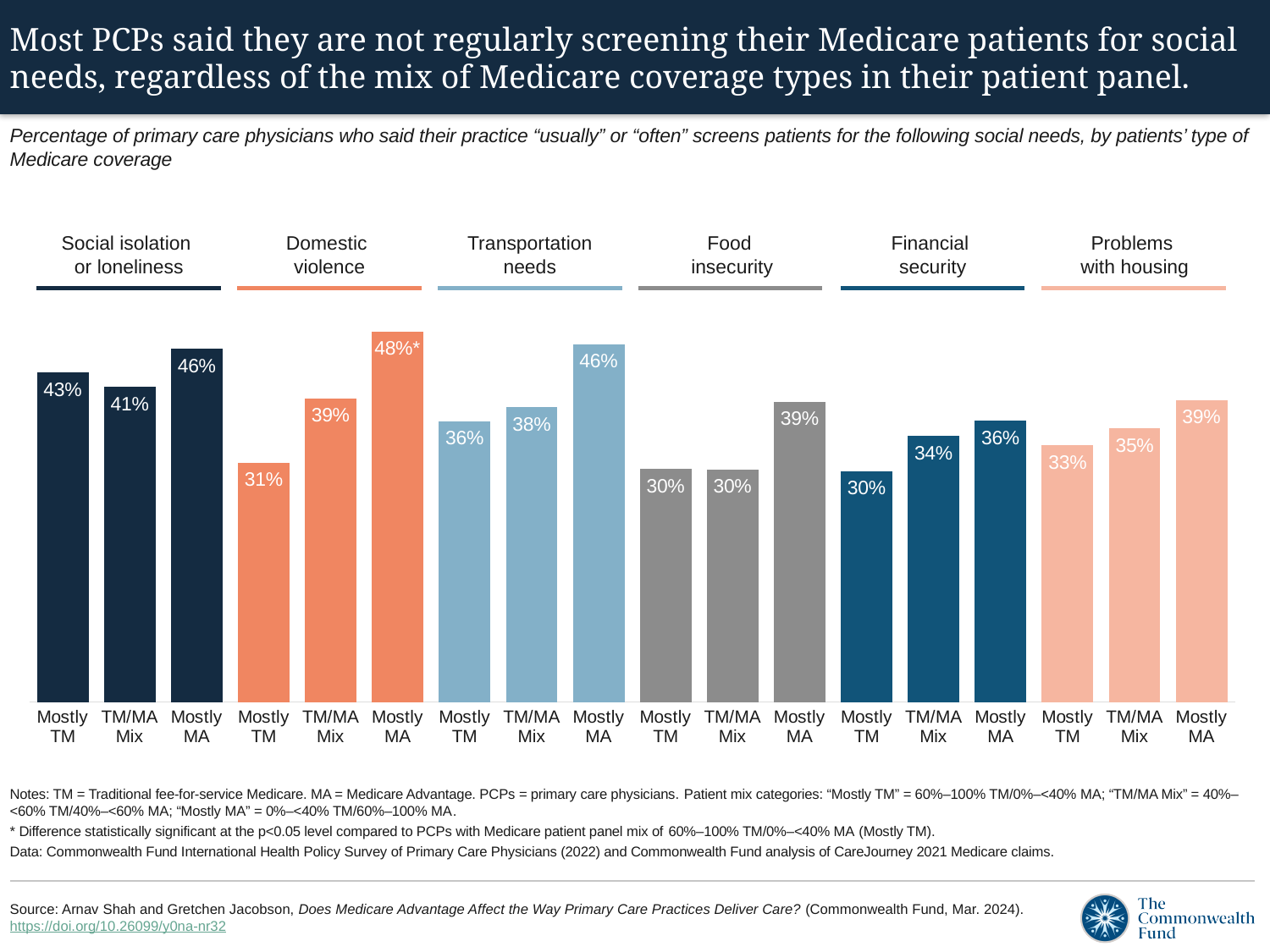
Which is larger: the Mostly TM value for Social isolation or loneliness, or the Mostly TM value for Transportation needs? Social isolation or loneliness Which patient mix category has the highest value within the Problems with housing group? Mostly MA What is the difference between the Mostly MA and TM/MA Mix values for Food insecurity? 9 percentage points Which patient mix category has the lowest value within the Domestic violence group? Mostly TM Within the Financial security group, do the values rise or fall moving from Mostly TM to Mostly MA? Rise How many social need categories are shown on the chart? 6 What type of chart is shown on the slide? Bar chart What percentage of PCPs with a Mostly TM patient mix said their practice usually or often screens for social isolation or loneliness? 43% What is the value for TM/MA Mix under Transportation needs? 38% What is the value for Mostly MA under Domestic violence? 48%* What is the value for Mostly TM under Financial security? 30% What is the difference between the Mostly MA and Mostly TM values for Domestic violence? 17 percentage points